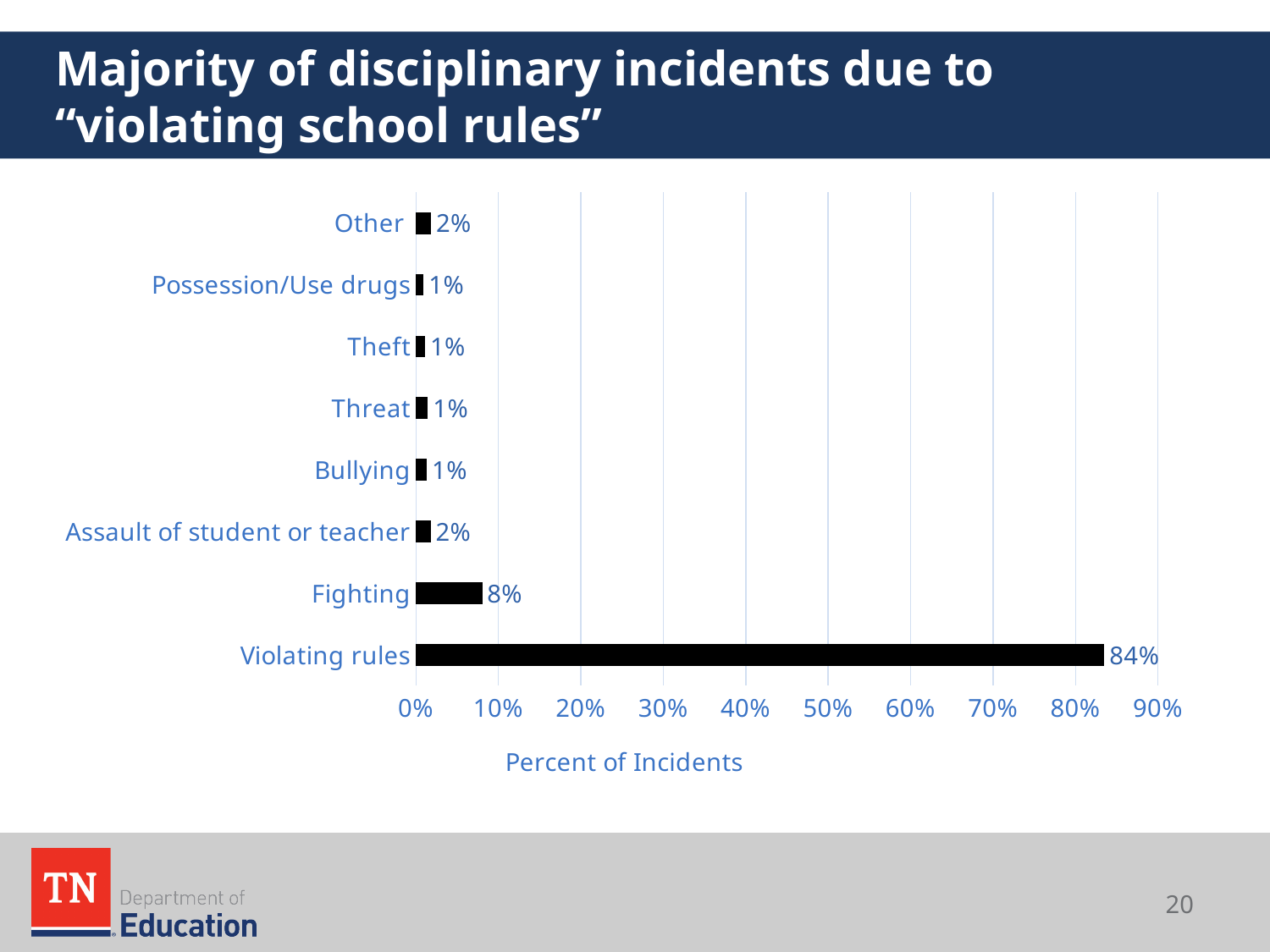
How many categories are shown in the chart? 8 What percent of incidents is shown for Assault of student or teacher? 2% What kind of chart is shown on the slide? Bar chart What is the label of the horizontal axis? Percent of Incidents Which has a larger percent of incidents, Fighting or Theft? Fighting What percent of incidents is shown for Fighting? 8% What is the difference in percent of incidents between Violating rules and Fighting? 76% What percent of incidents is shown for Violating rules? 84% What percent of incidents is shown for Bullying? 1% Is the value for Violating rules greater or less than 80%? greater What is the difference in percent of incidents between Fighting and Other? 6% Which category has the highest percent of incidents? Violating rules